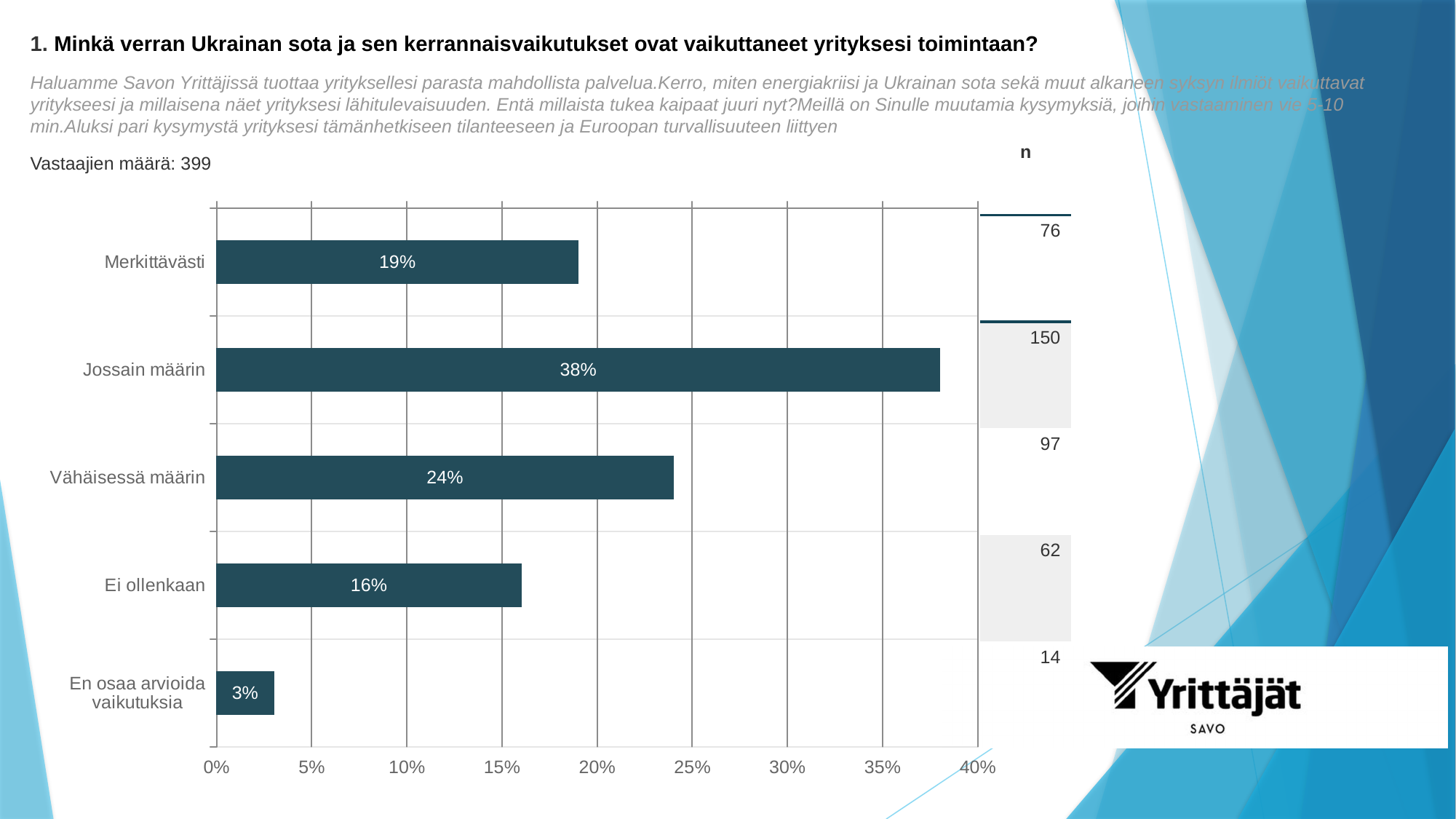
What is the maximum value shown on the percentage axis? 40% Is the value for "Merkittävästi" greater or less than 20%? less Which is larger, the percentage for "Vähäisessä määrin" or for "Ei ollenkaan"? Vähäisessä määrin How many categories are shown in the chart? 5 What kind of chart is shown on the slide? bar chart Which category has the highest percentage? Jossain määrin What is the difference in percentage points between "Jossain määrin" and "Merkittävästi"? 19 What percentage is shown for "Ei ollenkaan"? 16% What is the total number of respondents (Vastaajien määrä) stated on the slide? 399 Which category has the lowest percentage? En osaa arvioida vaikutuksia What is the n value shown for "Vähäisessä määrin"? 97 What percentage is shown for "Jossain määrin"? 38%